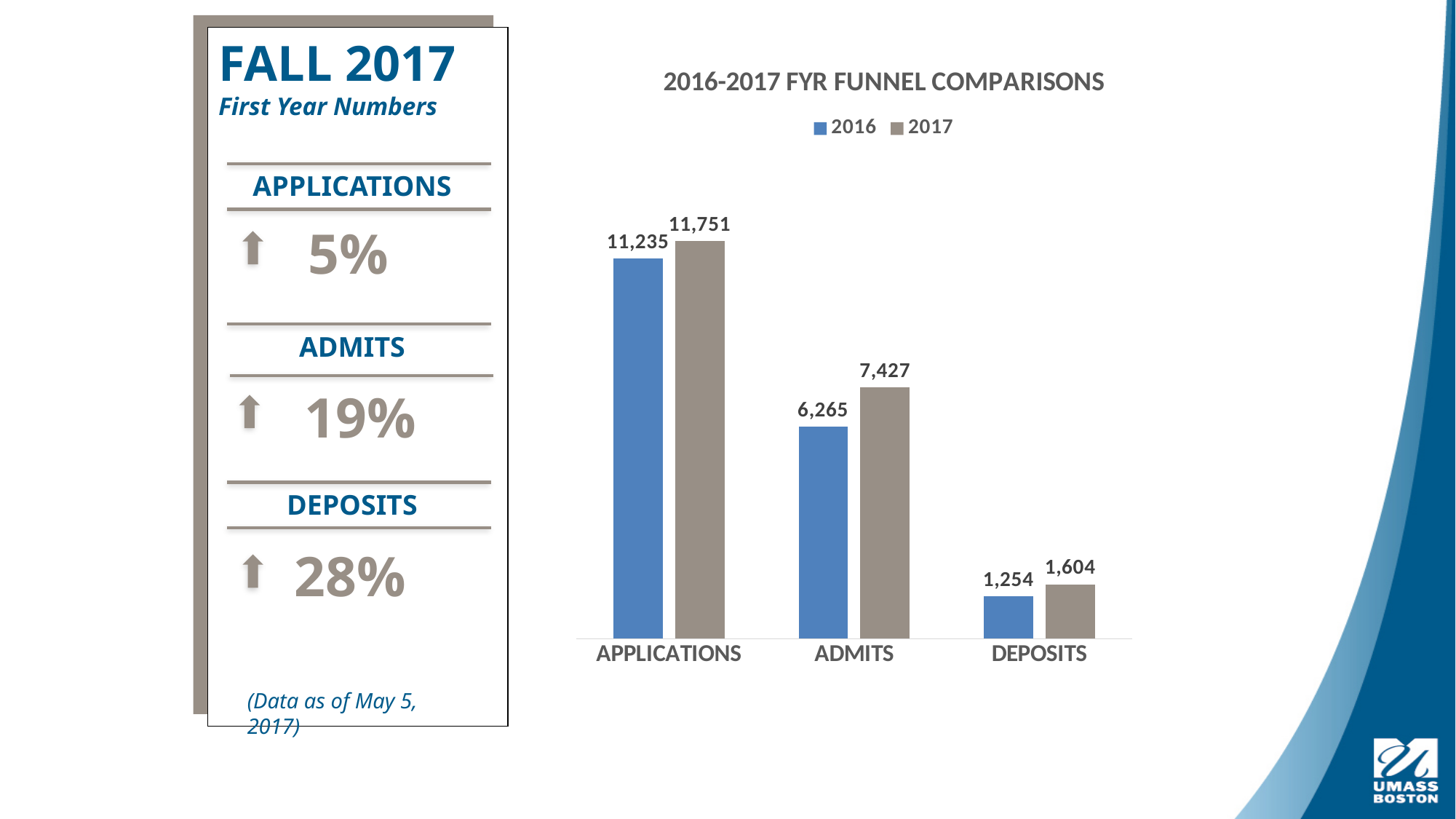
Which category has the highest 2017 value? APPLICATIONS What is the 2017 value for DEPOSITS? 1,604 How many categories are shown on the x axis? 3 What is the 2017 value for ADMITS? 7,427 What is the 2016 value for DEPOSITS? 1,254 Which is larger, the 2016 value for ADMITS or the 2017 value for ADMITS? 2017 What is the 2016 value for APPLICATIONS? 11,235 How many series does the legend list? 2 Which category has the lowest 2016 value? DEPOSITS What is the difference between the 2017 and 2016 values for ADMITS? 1,162 What is the difference between the 2017 and 2016 values for APPLICATIONS? 516 What kind of chart is shown? bar chart